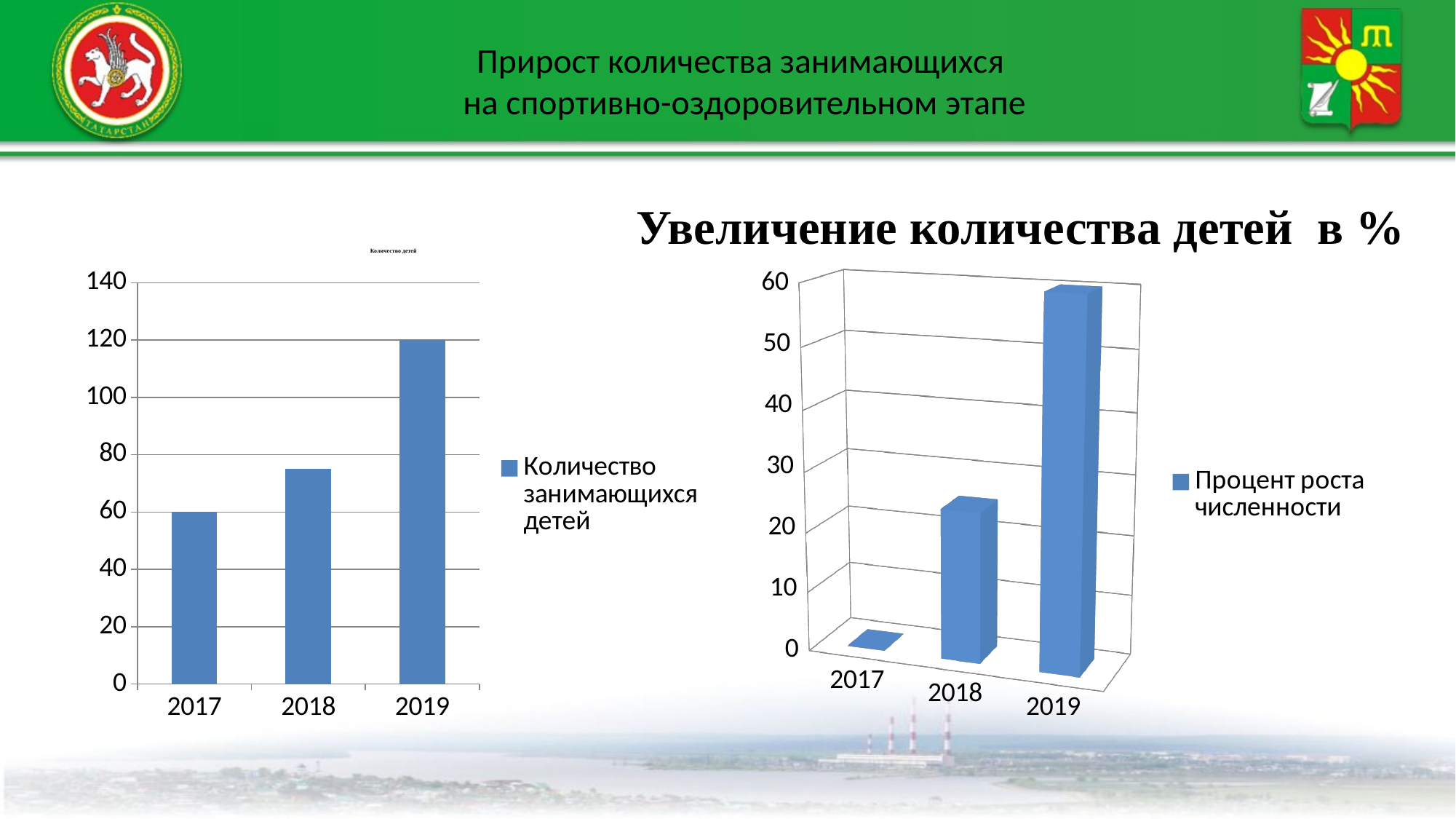
On the left chart (Количество детей), do the values rise or fall from 2017 to 2019? rise On the left chart (Количество детей), which year has the lowest value? 2017 On the left chart (Количество детей), which year has the highest value? 2019 On the right chart (Увеличение количества детей в %), is the value for 2019 greater or less than 50? greater On the left chart (Количество детей), what is the value for 2017? 60 What is the legend entry on the right chart (Увеличение количества детей в %)? Процент роста численности On the left chart (Количество детей), is the value for 2018 greater or less than 80? less On the right chart (Увеличение количества детей в %), is the value for 2017 greater or less than 10? less On the left chart (Количество детей), what is the value for 2019? 120 On the left chart (Количество детей), what is the difference between the values for 2019 and 2017? 60 How many years are shown on the right chart (Увеличение количества детей в %)? 3 On the right chart (Увеличение количества детей в %), which year has the highest value? 2019